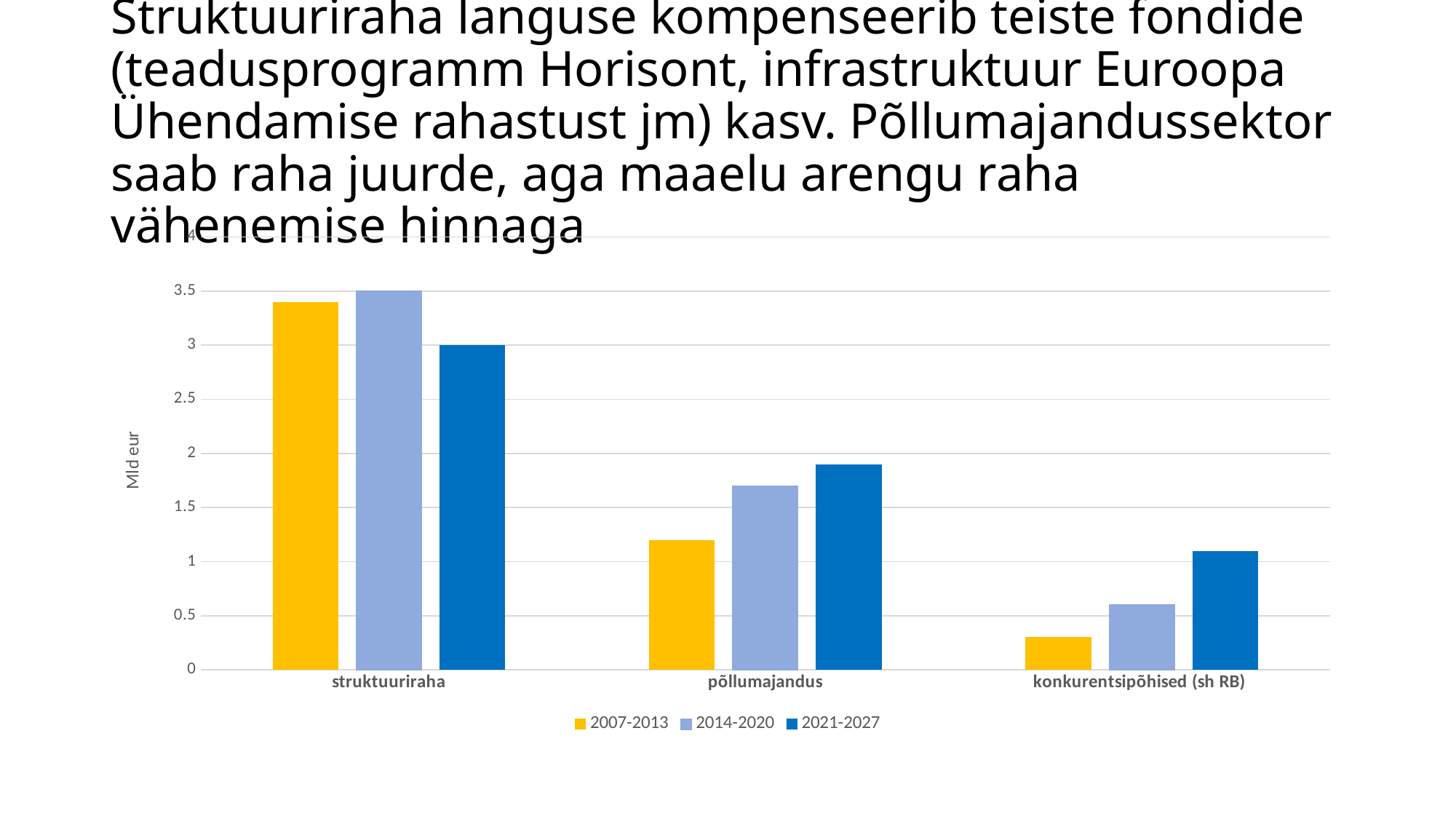
What is the value for struktuuriraha in the 2014-2020 series? 3.5 Which category has the lowest value in the 2007-2013 series? konkurentsipõhised (sh RB) Is the value for põllumajandus in the 2007-2013 series greater or less than 1? greater Is the value for konkurentsipõhised (sh RB) in the 2007-2013 series greater or less than 0.5? less What is the label of the vertical axis? Mld eur What is the value for struktuuriraha in the 2021-2027 series? 3 Is the value for põllumajandus in the 2021-2027 series greater or less than 2? less What kind of chart is shown on the slide? bar chart For põllumajandus, which series has the larger value: 2007-2013 or 2021-2027? 2021-2027 How many categories are shown on the x axis? 3 How many series does the legend list? 3 Which category has the highest value in the 2021-2027 series? struktuuriraha